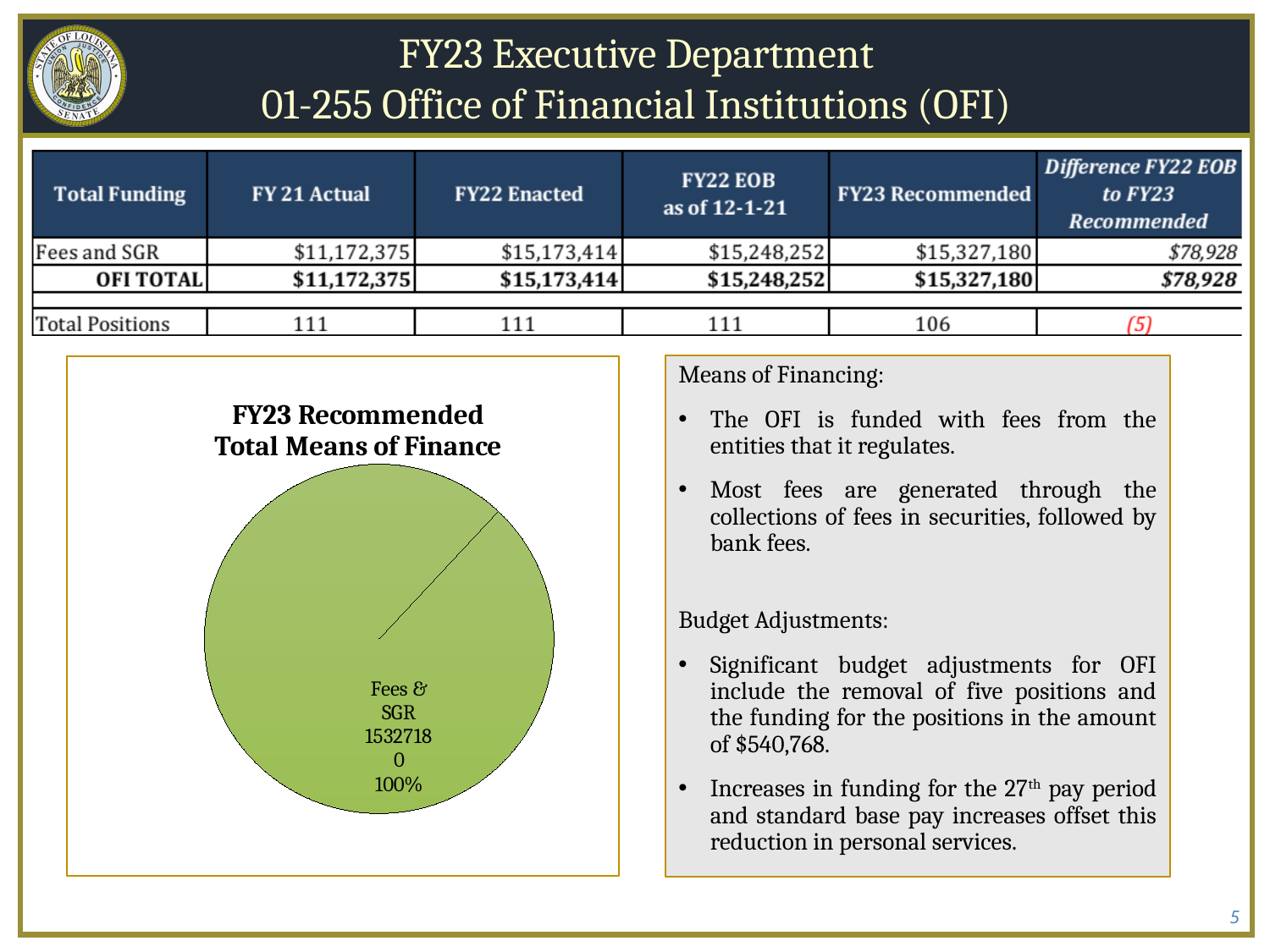
What is the name of the only category shown in the pie chart? Fees & SGR What colour is the Fees & SGR slice in the pie chart? green What kind of chart is shown on the slide? pie chart What is the title of the pie chart? FY23 Recommended Total Means of Finance What value is printed on the Fees & SGR slice of the pie chart? 15327180 How many slices does the pie chart have? 1 What share of the pie does the Fees & SGR slice represent? 100%